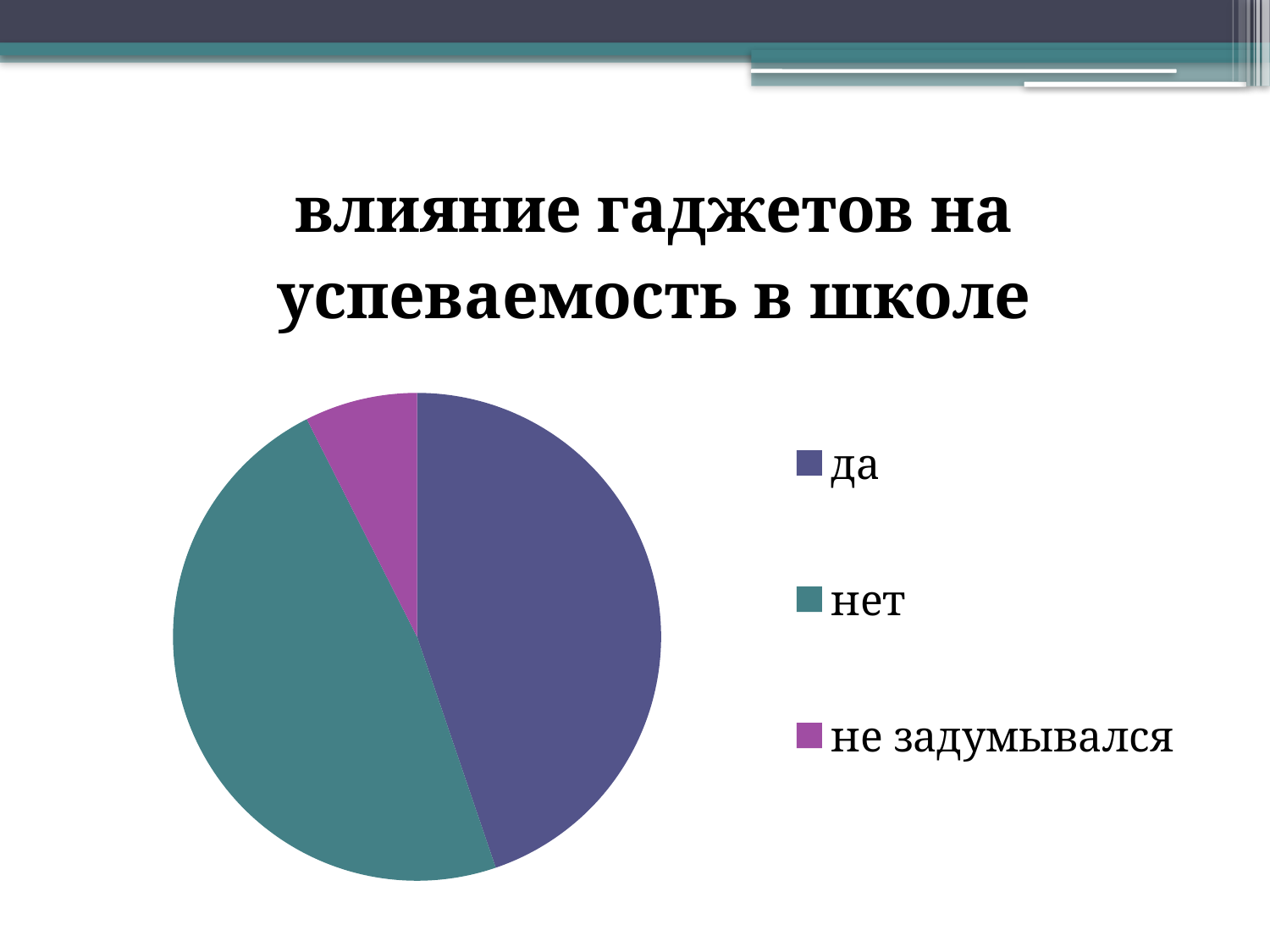
Which category has the smallest slice of the pie? не задумывался How many slices does the pie chart have? 3 What is the title of the chart? влияние гаджетов на успеваемость в школе Which slice is larger: "нет" or "не задумывался"? нет Which slice is larger: "да" or "не задумывался"? да How many entries does the legend list? 3 Which legend entry is shown in teal (green-blue)? нет What kind of chart is shown on the slide? pie chart